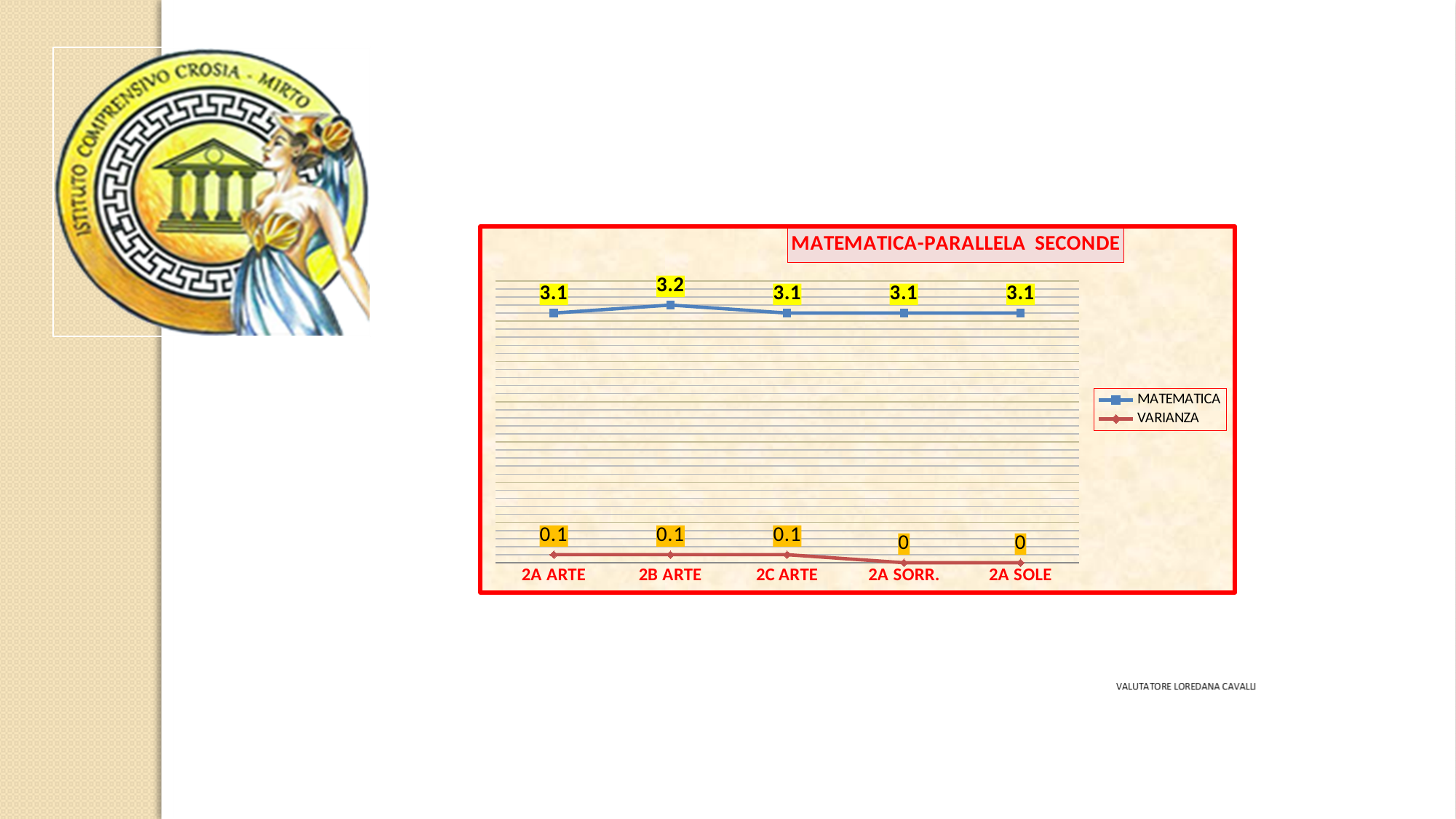
What is the VARIANZA value for 2C ARTE? 0.1 How many series does the legend list? 2 How many categories are shown on the x axis? 5 Which category has the highest MATEMATICA value? 2B ARTE What is the title of the chart? MATEMATICA-PARALLELA SECONDE What kind of chart is shown? Line chart Does the VARIANZA series rise or fall from 2C ARTE to 2A SORR.? Fall What is the VARIANZA value for 2A SORR.? 0 Which is larger, the VARIANZA value for 2A ARTE or for 2A SOLE? 2A ARTE What is the difference between the MATEMATICA values for 2B ARTE and 2A ARTE? 0.1 What is the MATEMATICA value for 2A SOLE? 3.1 What is the MATEMATICA value for 2B ARTE? 3.2